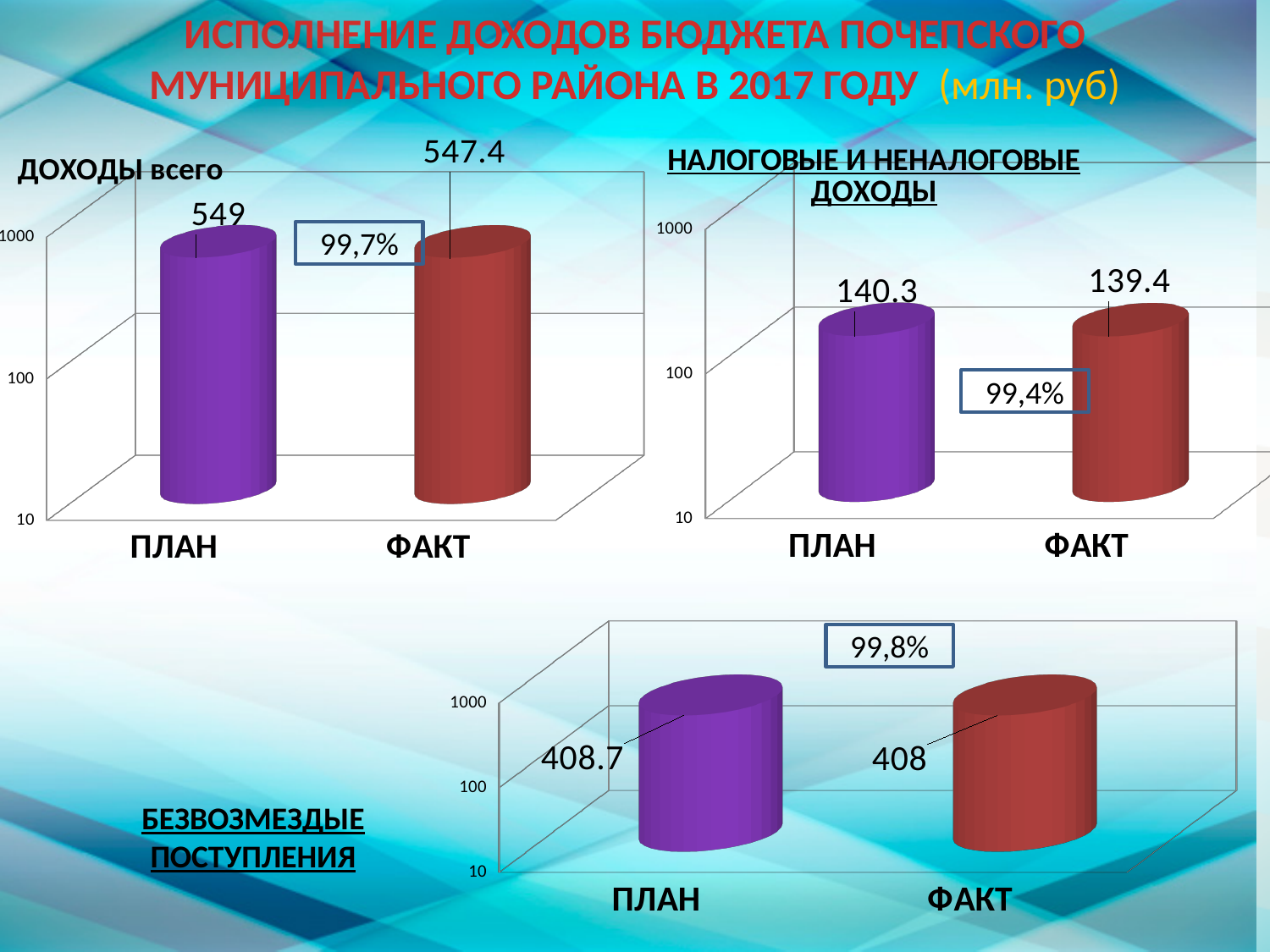
In the chart titled "ДОХОДЫ всего", what is the value for ФАКТ? 547.4 In the chart titled "ДОХОДЫ всего", what is the value for ПЛАН? 549 In the chart titled "НАЛОГОВЫЕ И НЕНАЛОГОВЫЕ ДОХОДЫ", what is the value for ПЛАН? 140.3 In the chart titled "БЕЗВОЗМЕЗДНЫЕ ПОСТУПЛЕНИЯ", what is the value for ФАКТ? 408 In the chart titled "НАЛОГОВЫЕ И НЕНАЛОГОВЫЕ ДОХОДЫ", what is the value for ФАКТ? 139.4 What kind of chart is the chart titled "НАЛОГОВЫЕ И НЕНАЛОГОВЫЕ ДОХОДЫ"? Bar chart In the chart titled "НАЛОГОВЫЕ И НЕНАЛОГОВЫЕ ДОХОДЫ", what is the difference between the ПЛАН and ФАКТ values? 0.9 In the chart titled "ДОХОДЫ всего", what is the difference between the ПЛАН and ФАКТ values? 1.6 In the chart titled "ДОХОДЫ всего", how many categories are shown on the x axis? 2 In the chart titled "БЕЗВОЗМЕЗДНЫЕ ПОСТУПЛЕНИЯ", which is larger according to the data labels, ПЛАН or ФАКТ? ПЛАН In the chart titled "БЕЗВОЗМЕЗДНЫЕ ПОСТУПЛЕНИЯ", what is the value for ПЛАН? 408.7 In the chart titled "ДОХОДЫ всего", what percentage is shown in the box between the two bars? 99,7%